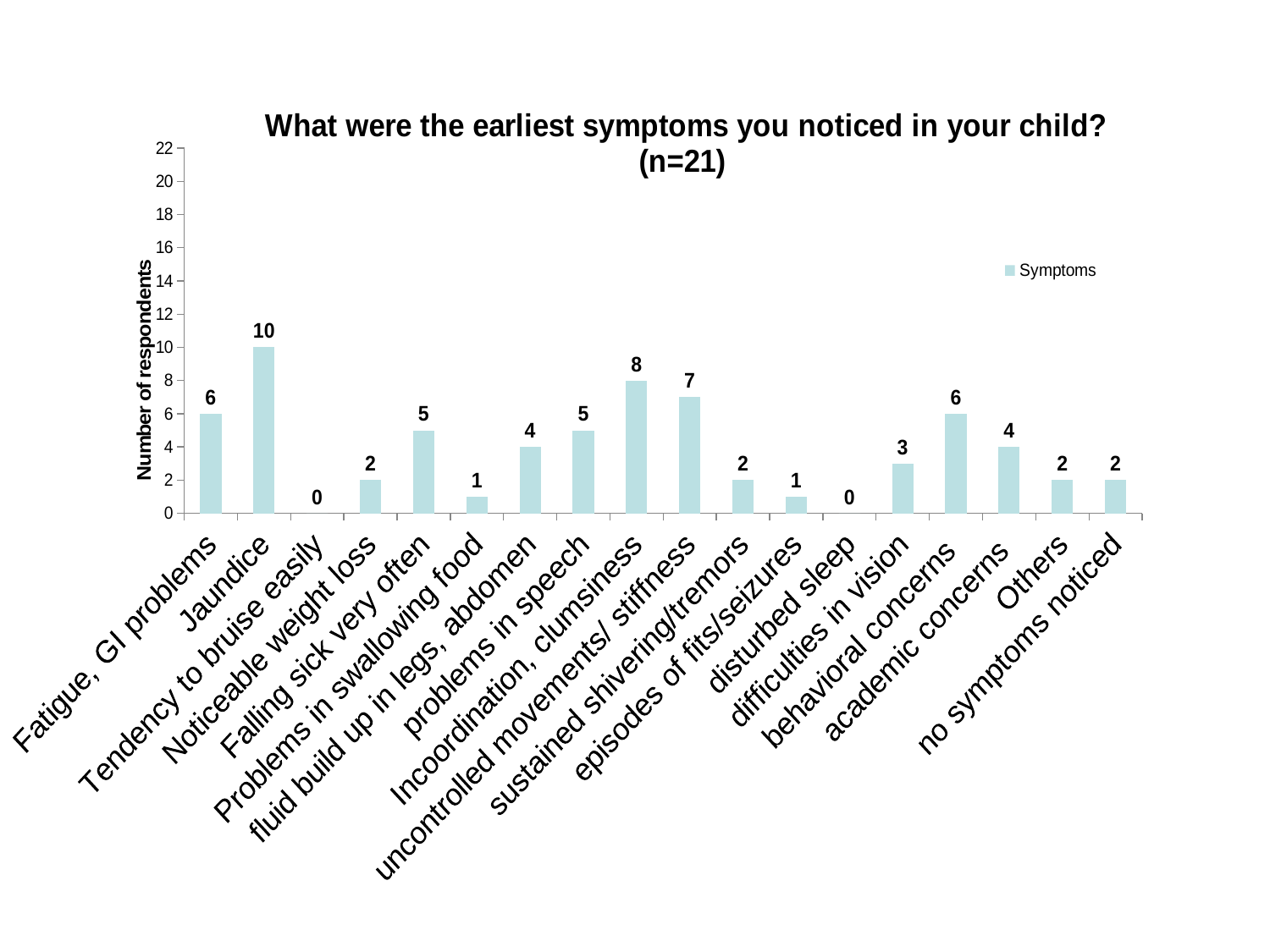
What value is shown for 'behavioral concerns'? 6 What is the number of respondents for 'Incoordination, clumsiness'? 8 How many respondents reported Jaundice as an earliest symptom? 10 Which has more respondents: 'Falling sick very often' or 'fluid build up in legs, abdomen'? Falling sick very often How many respondents noticed 'difficulties in vision'? 3 Which symptom has the highest number of respondents? Jaundice Which two symptoms have a value of 0? Tendency to bruise easily and disturbed sleep What is the difference between the values for Jaundice and 'uncontrolled movements/ stiffness'? 3 What type of chart is shown on the slide? Bar chart How many series does the legend list? 1 What is the sample size (n) stated in the chart title? 21 How many symptom categories are shown on the x axis? 18